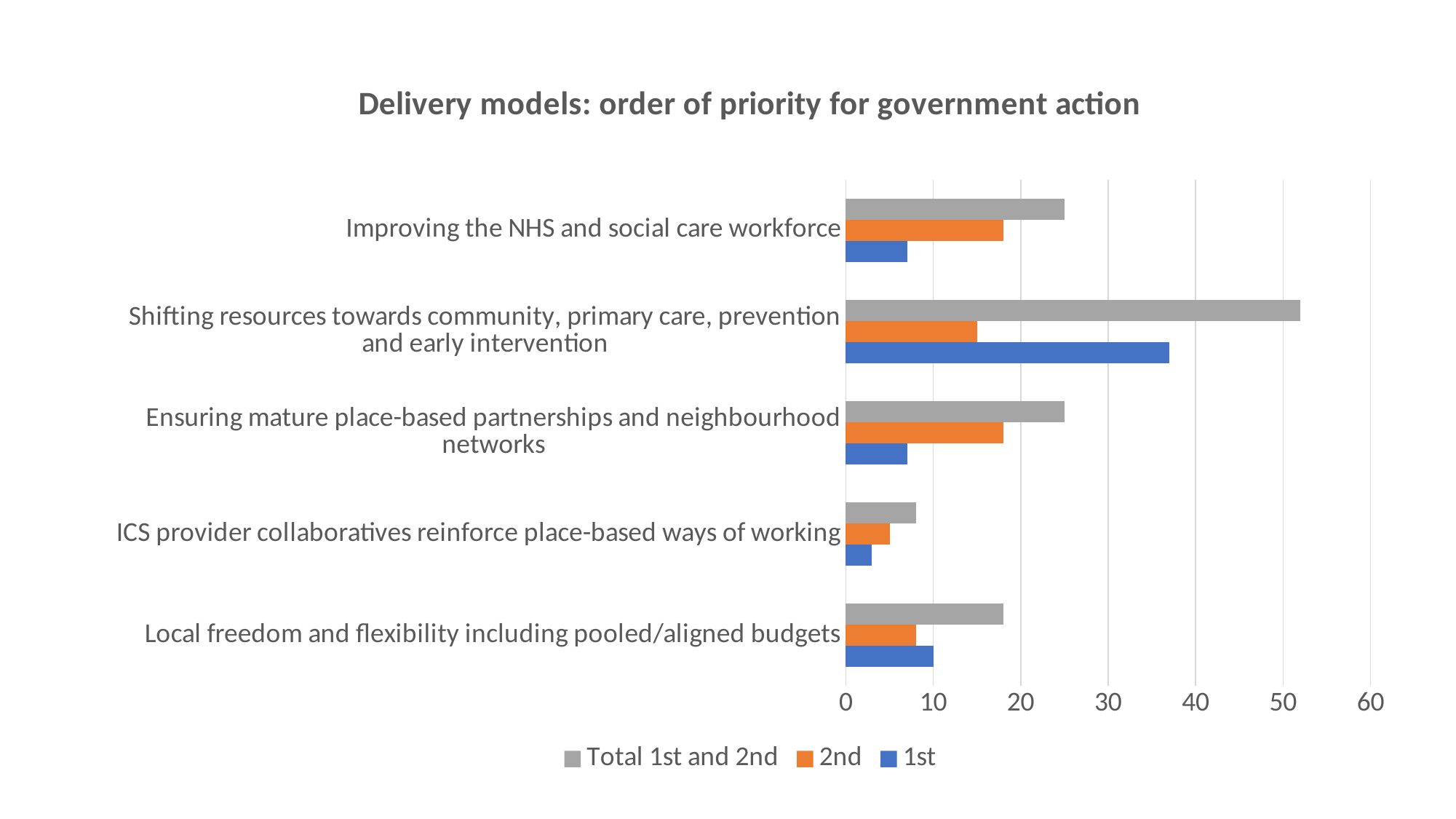
How many categories are shown on the chart? 5 Which category has the highest value for the 'Total 1st and 2nd' series? Shifting resources towards community, primary care, prevention and early intervention How many series does the legend list? 3 Which category has the lowest value for the 'Total 1st and 2nd' series? ICS provider collaboratives reinforce place-based ways of working Which series is shown in orange in the legend? 2nd What is the title of the chart? Delivery models: order of priority for government action Is the 'Total 1st and 2nd' value for 'Shifting resources towards community, primary care, prevention and early intervention' greater or less than 40? greater Is the 'Total 1st and 2nd' value for 'Improving the NHS and social care workforce' greater or less than 20? greater Is the 'Total 1st and 2nd' value for 'ICS provider collaboratives reinforce place-based ways of working' greater or less than 10? less For 'Improving the NHS and social care workforce', which is larger: the '2nd' value or the '1st' value? 2nd What type of chart is shown on the slide? Bar chart